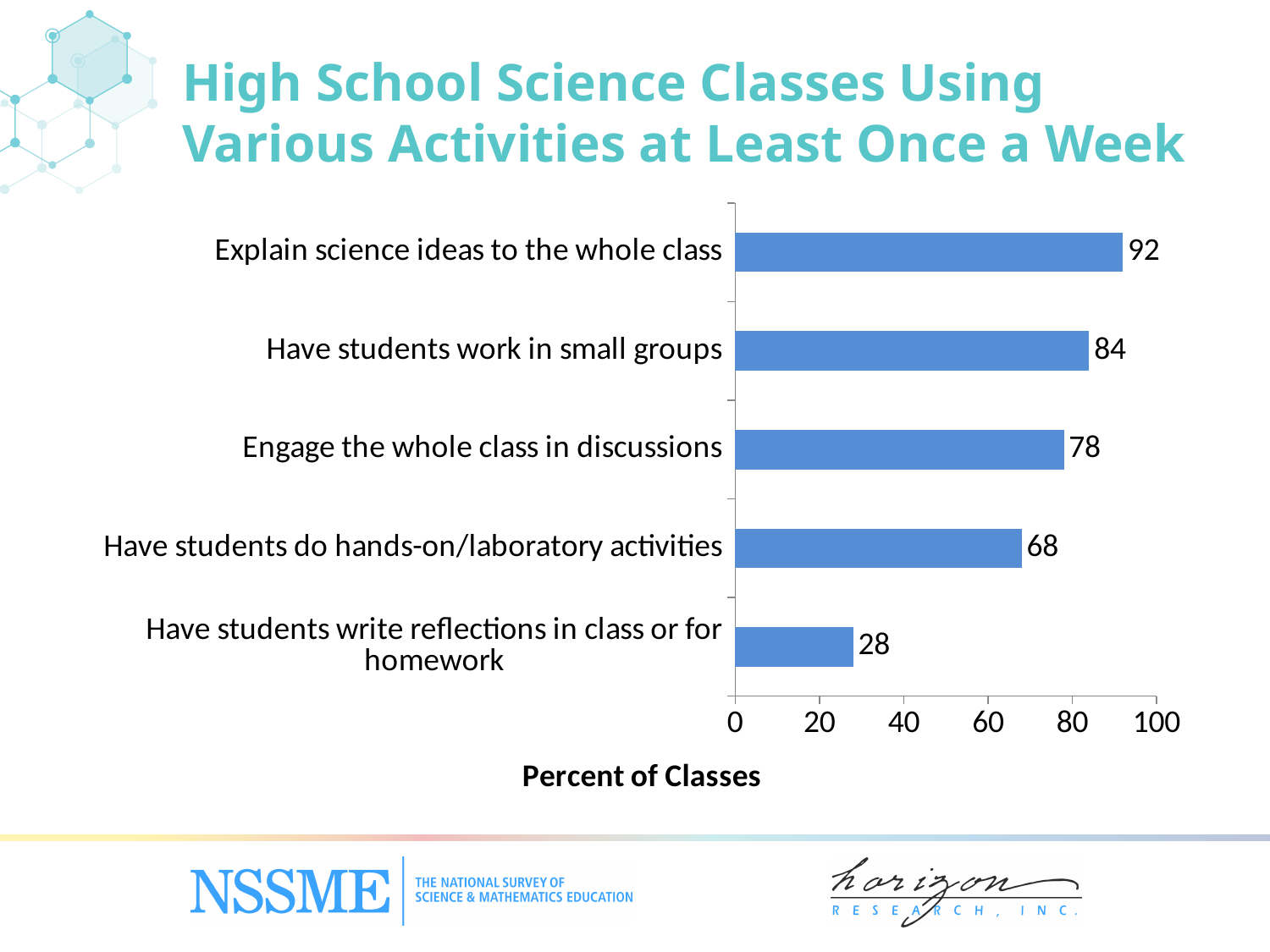
Is the value for 'Have students do hands-on/laboratory activities' greater or less than 60? greater What is the difference between the values for 'Have students do hands-on/laboratory activities' and 'Have students write reflections in class or for homework'? 40 What is the value for 'Have students write reflections in class or for homework'? 28 How many activities are shown in the chart? 5 What percent of classes have students work in small groups at least once a week? 84 Which activity has the lowest percent of classes? Have students write reflections in class or for homework What is the difference between the values for 'Explain science ideas to the whole class' and 'Engage the whole class in discussions'? 14 Which is larger: the value for 'Have students work in small groups' or 'Engage the whole class in discussions'? Have students work in small groups Which activity has the highest percent of classes? Explain science ideas to the whole class What is the label of the horizontal axis? Percent of Classes What kind of chart is shown on the slide? bar chart What is the value for 'Have students do hands-on/laboratory activities'? 68